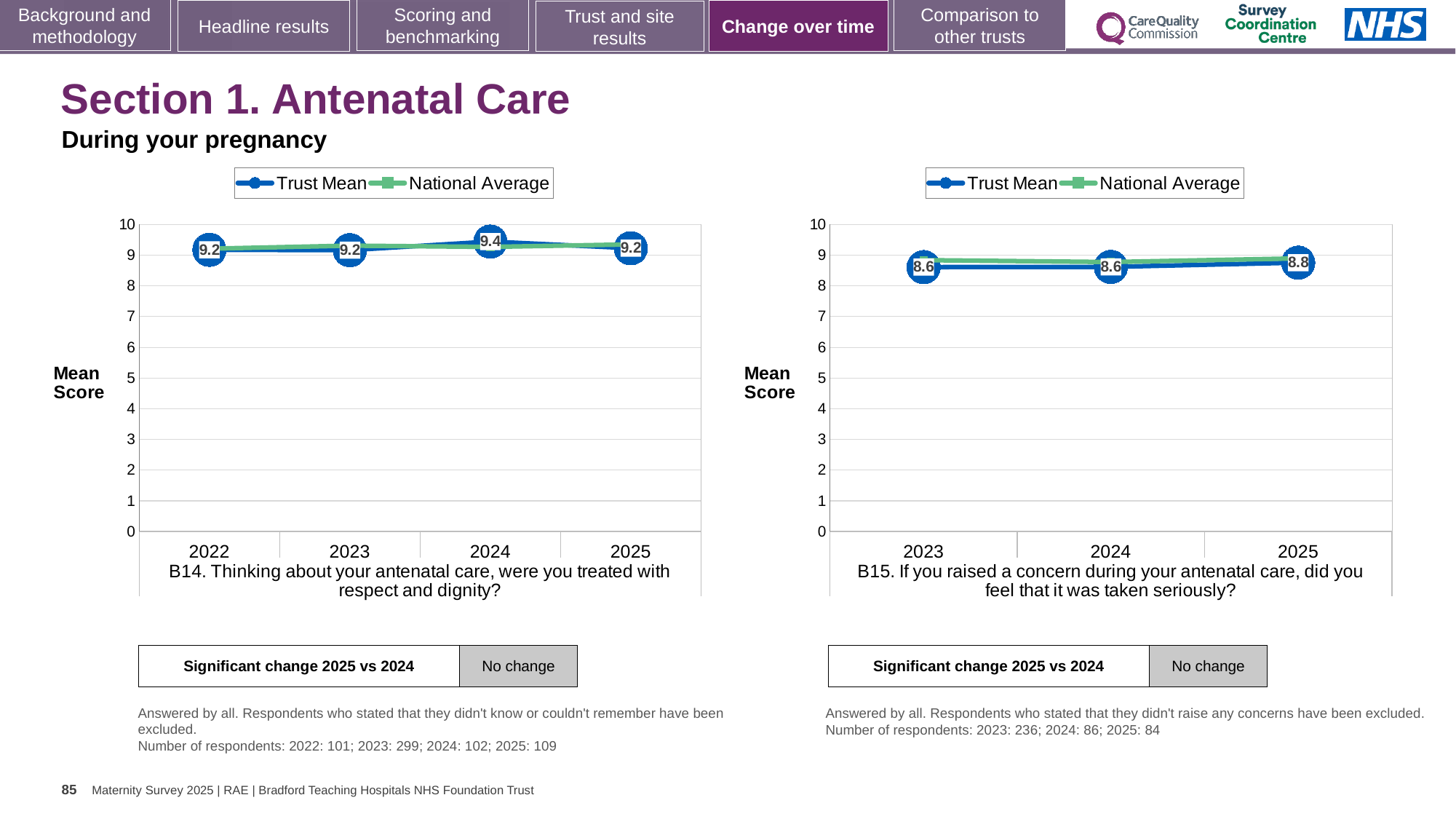
On the left chart (B14), what is the Trust Mean for 2022? 9.2 On the right chart (B15), which year has the highest Trust Mean? 2025 How many years are plotted on the left chart (B14)? 4 On the left chart (B14), which year has the highest Trust Mean? 2024 On the right chart (B15), what is the Trust Mean for 2023? 8.6 On the right chart (B15), what is the difference between the Trust Mean for 2025 and 2024? 0.2 What kind of chart is the left chart (B14)? Line chart On the right chart (B15), is the National Average for 2024 greater or less than 8? greater How many series does the legend of the right chart (B15) list? 2 On the left chart (B14), what is the difference between the Trust Mean for 2024 and 2025? 0.2 On the left chart (B14), what is the Trust Mean for 2024? 9.4 On the right chart (B15), what is the Trust Mean for 2025? 8.8